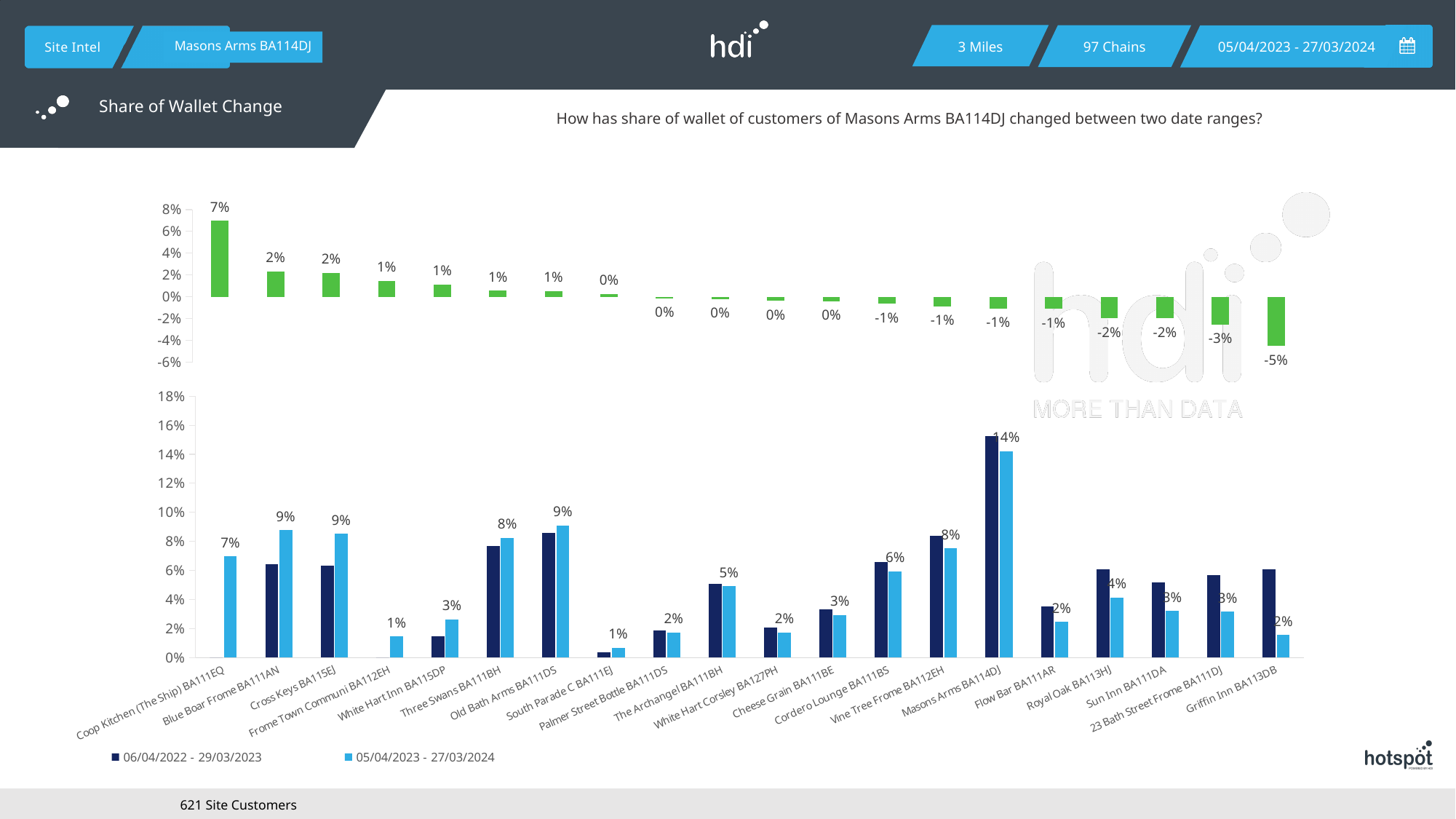
In the bottom chart, how many categories are shown on the x axis? 20 In the bottom chart, is the 06/04/2022 - 29/03/2023 value for Masons Arms BA114DJ greater or less than 14%? greater In the top chart (share of wallet change), which category has the lowest value? Griffin Inn BA113DB In the bottom chart, how many series does the legend list? 2 What kind of chart is the bottom chart? Bar chart What are the two legend entries of the bottom chart? 06/04/2022 - 29/03/2023 and 05/04/2023 - 27/03/2024 In the top chart (share of wallet change), what is the value for Sun Inn BA111DA? -2% In the bottom chart, what is the 05/04/2023 - 27/03/2024 value for Masons Arms BA114DJ? 14% In the bottom chart, what is the difference between the 05/04/2023 - 27/03/2024 values for Masons Arms BA114DJ and Cordero Lounge BA111BS? 8% In the top chart (share of wallet change), what is the value for Coop Kitchen (The Ship) BA111EQ? 7% In the top chart (share of wallet change), which category has the highest value? Coop Kitchen (The Ship) BA111EQ In the bottom chart, for the 05/04/2023 - 27/03/2024 series, which is larger: Blue Boar Frome BA111AN or Frome Town Communi BA112EH? Blue Boar Frome BA111AN